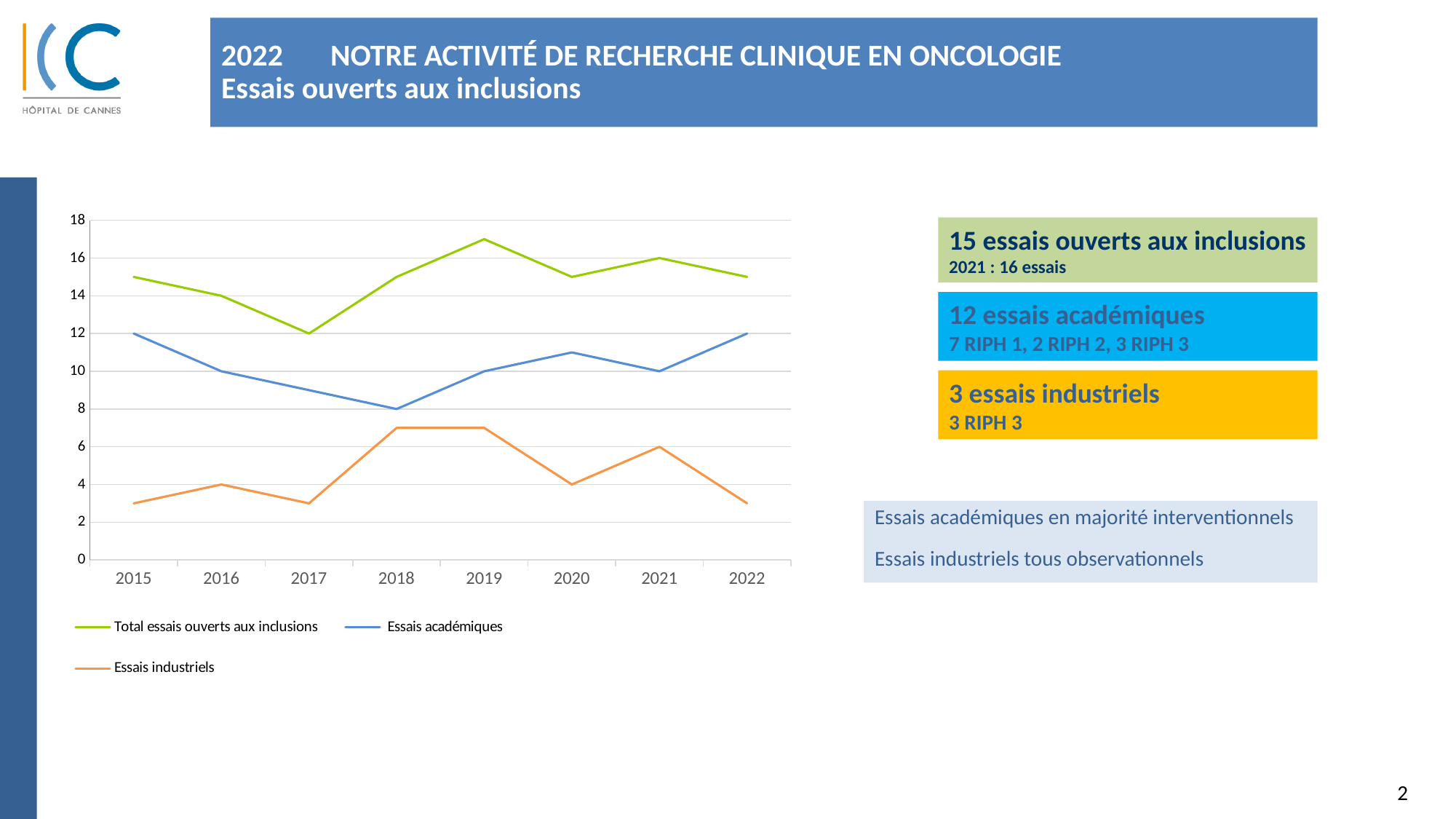
Does the Essais académiques line rise or fall from 2015 to 2018? fall In which year is Essais académiques lowest? 2018 How many years are plotted along the x axis of the chart? 8 What type of chart is shown on the slide? line chart What is the difference between Essais académiques in 2015 and in 2018? 4 What is the value of Essais académiques in 2015? 12 How many series does the chart legend list? 3 What is the value of Total essais ouverts aux inclusions in 2017? 12 In which year is Total essais ouverts aux inclusions highest? 2019 Which year has the larger value for Essais industriels, 2016 or 2018? 2018 What is the value of Essais industriels in 2021? 6 Is the value for Total essais ouverts aux inclusions in 2019 greater or less than 16? greater